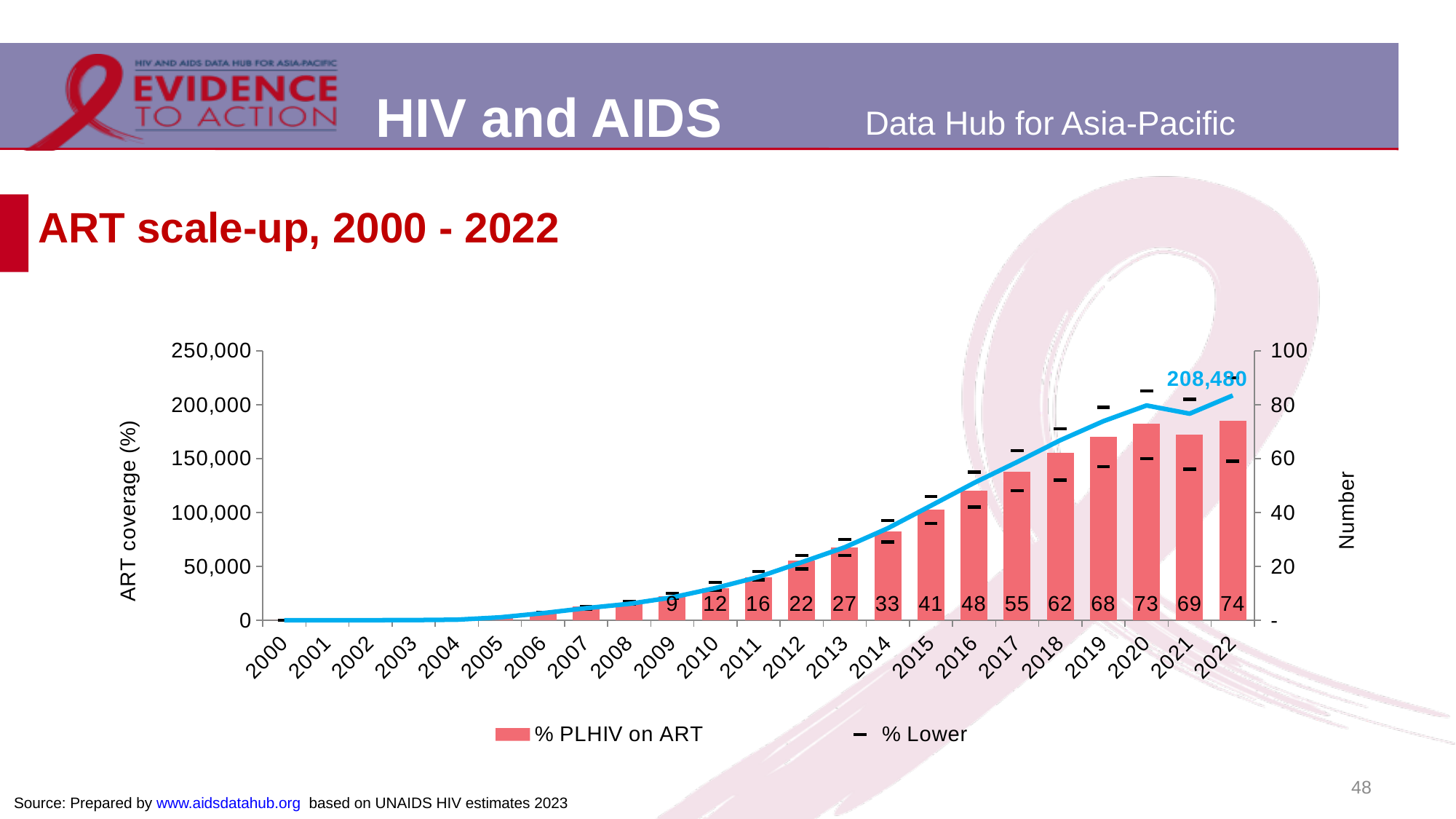
How many series does the legend list? 2 What is the % PLHIV on ART value for 2015? 41 Which year has the highest % PLHIV on ART bar? 2022 How many years are shown on the x axis? 23 What is the % PLHIV on ART value for 2022? 74 Which year has the larger % PLHIV on ART value, 2020 or 2021? 2020 Does the % PLHIV on ART value rise or fall from 2009 to 2020? Rise What is the % PLHIV on ART value for 2009? 9 What kind of chart is shown on the slide? A bar chart combined with a line chart What value is labelled on the blue line at 2022? 208,480 What is the difference between the % PLHIV on ART values for 2020 and 2010? 61 What is the difference between the % PLHIV on ART values for 2022 and 2021? 5